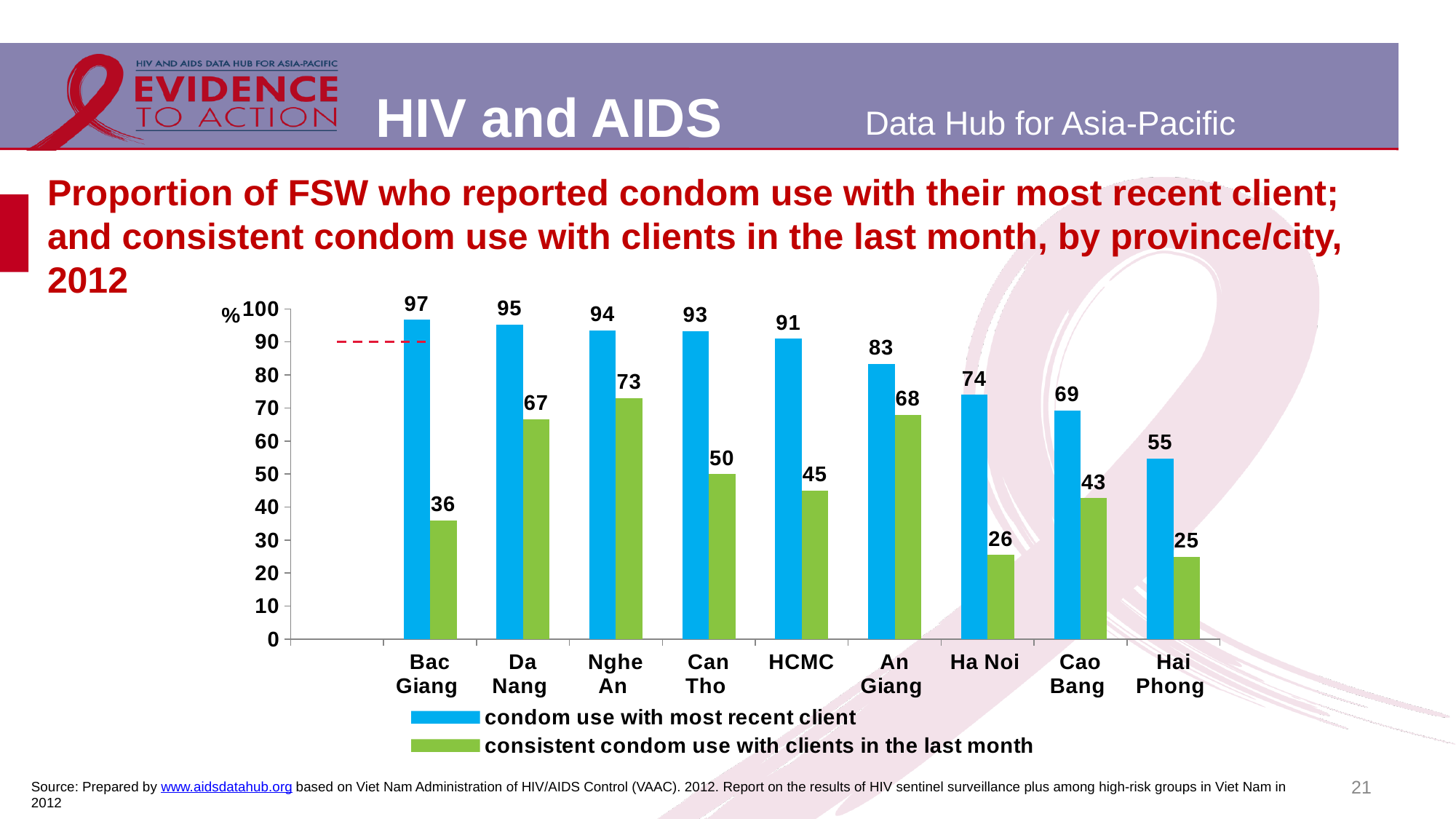
Which province/city has the highest value for condom use with most recent client? Bac Giang What colour are the bars for consistent condom use with clients in the last month? green What kind of chart is shown on the slide? bar chart What is the value for consistent condom use with clients in the last month in Nghe An? 73 Is the value for condom use with most recent client in Hai Phong greater or less than 60? less What is the value for condom use with most recent client in Bac Giang? 97 Which province/city has the lowest value for consistent condom use with clients in the last month? Hai Phong What is the difference between condom use with most recent client and consistent condom use with clients in the last month in Bac Giang? 61 Which is larger: consistent condom use with clients in the last month in Da Nang or in Can Tho? Da Nang How many series does the legend list? 2 What is the value for consistent condom use with clients in the last month in Ha Noi? 26 How many provinces/cities are shown on the x axis? 9